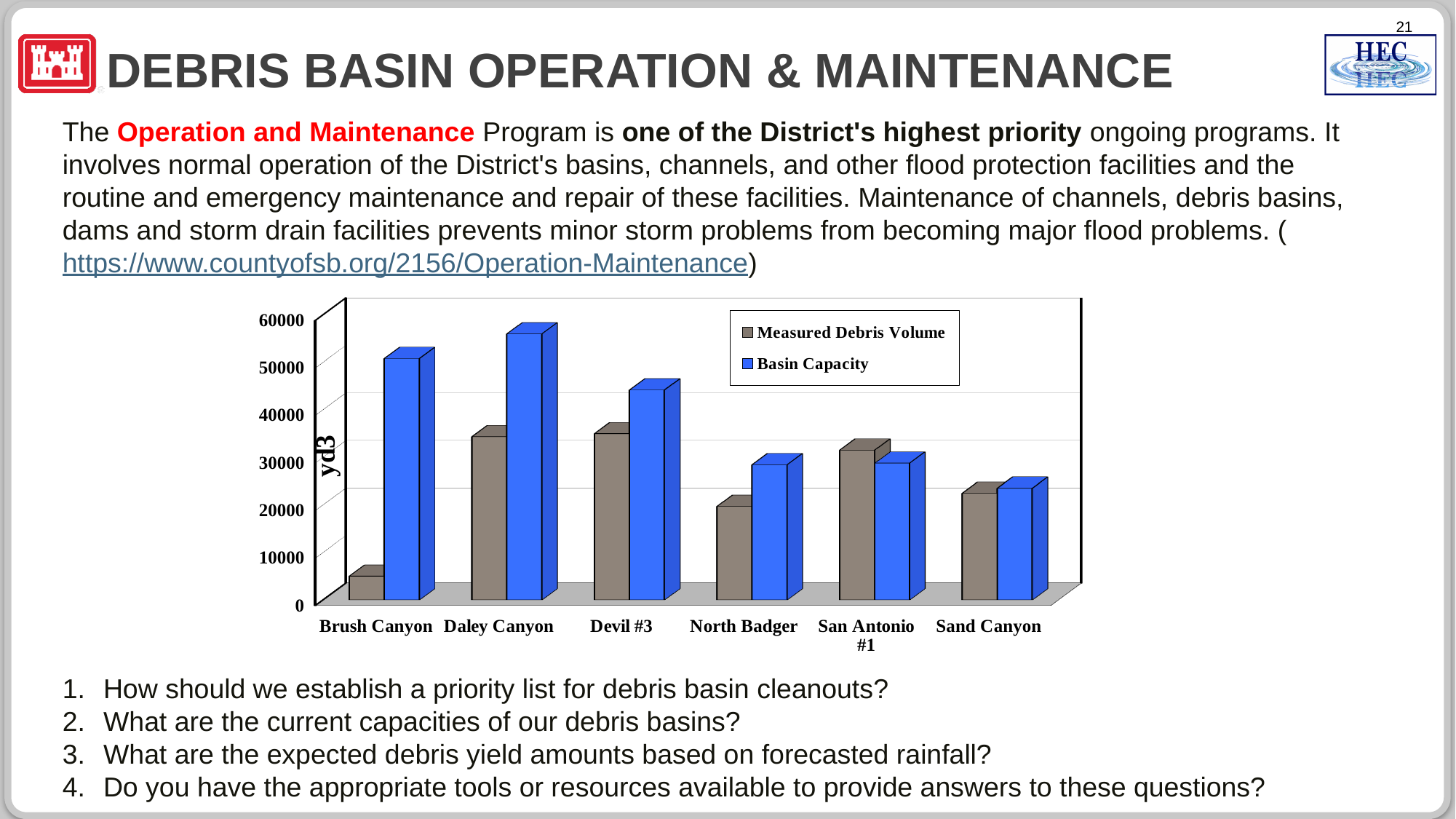
What unit is shown on the chart's vertical axis label? yd3 Which basin has the highest Basin Capacity in the chart? Daley Canyon Is the Measured Debris Volume for North Badger greater or less than 30000? less How many debris basins (categories) are shown on the x axis of the chart? 6 Which basin has the lowest Measured Debris Volume in the chart? Brush Canyon What kind of chart is shown on the slide? Bar chart Is the Basin Capacity for Brush Canyon greater or less than 40000? greater Is the Basin Capacity for Daley Canyon greater or less than 50000? greater For Brush Canyon, which is larger: Measured Debris Volume or Basin Capacity? Basin Capacity How many series does the chart's legend list? 2 Which colour represents Basin Capacity in the chart's legend? Blue